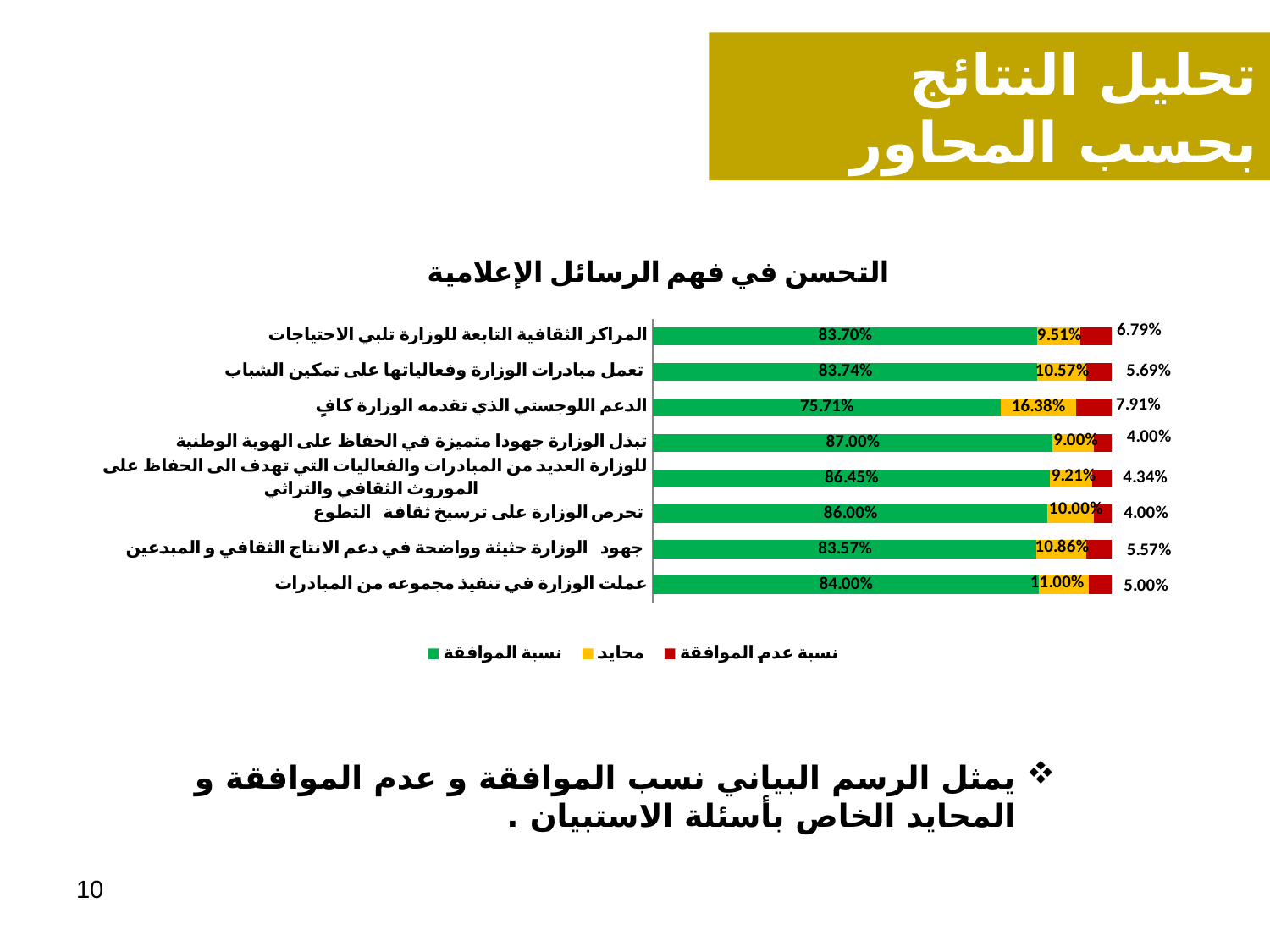
How many series does the chart legend list? 3 Which statement has the highest agreement percentage (نسبة الموافقة)? تبذل الوزارة جهودا متميزة في الحفاظ على الهوية الوطنية What is the disagreement percentage (نسبة عدم الموافقة) for 'المراكز الثقافية التابعة للوزارة تلبي الاحتياجات'? 6.79% Which statement has the highest neutral percentage (محايد)? الدعم اللوجستي الذي تقدمه الوزارة كافٍ How many categories (statements) are plotted in the chart? 8 What is the title of the chart? التحسن في فهم الرسائل الإعلامية What is the neutral percentage (محايد) for 'عملت الوزارة في تنفيذ مجموعه من المبادرات'? 11.00% What type of chart is shown on the slide? Stacked bar chart What is the agreement percentage (نسبة الموافقة) for 'الدعم اللوجستي الذي تقدمه الوزارة كافٍ'? 75.71% Which is larger: the disagreement percentage for 'الدعم اللوجستي الذي تقدمه الوزارة كافٍ' or for 'تحرص الوزارة على ترسيخ ثقافة التطوع'? الدعم اللوجستي الذي تقدمه الوزارة كافٍ Which statement has the lowest agreement percentage (نسبة الموافقة)? الدعم اللوجستي الذي تقدمه الوزارة كافٍ What is the difference between the agreement percentage for 'تبذل الوزارة جهودا متميزة في الحفاظ على الهوية الوطنية' and for 'الدعم اللوجستي الذي تقدمه الوزارة كافٍ'? 11.29%